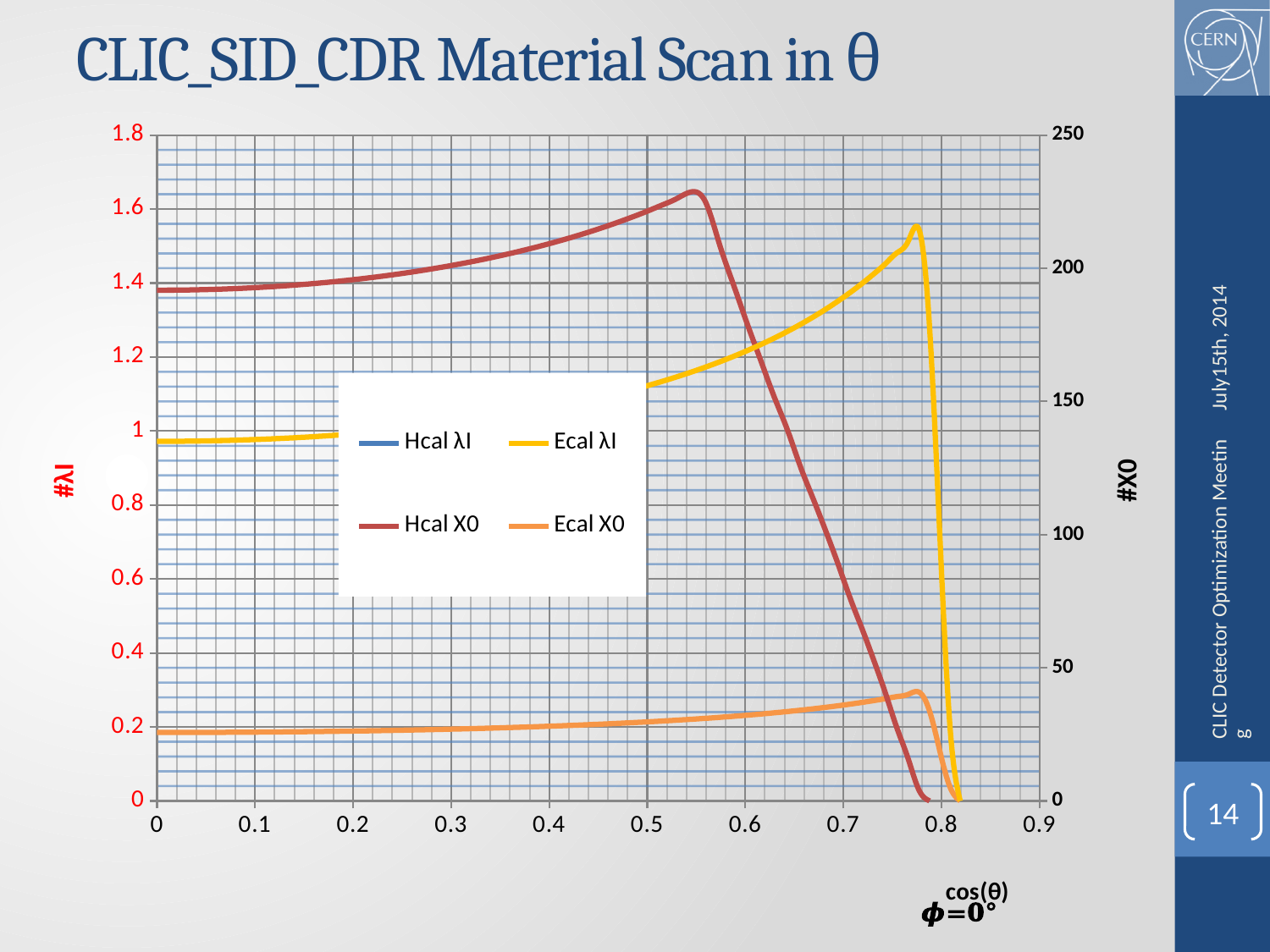
What is the title of the chart? CLIC_SID_CDR Material Scan in θ At cos(θ)=0, which line is higher on the chart, Hcal X0 or Ecal X0? Hcal X0 Does the Hcal X0 line rise or fall between cos(θ)=0.6 and cos(θ)=0.8? fall Does the Ecal X0 line rise or fall between cos(θ)=0 and cos(θ)=0.7? rise On the right-hand #X0 axis, is the value for Hcal X0 at cos(θ)=0 greater or less than 150? greater On the left-hand #λI axis, is the value for Ecal λI at cos(θ)=0 greater or less than 0.8? greater How many series does the legend list? 4 On the right-hand #X0 axis, is the value for Ecal X0 at cos(θ)=0 greater or less than 50? less Which series reaches its peak at a larger cos(θ) value, Hcal X0 or Ecal λI? Ecal λI What kind of chart is shown on the slide? line chart What are the four series named in the legend? Hcal λI, Ecal λI, Hcal X0, Ecal X0 How many labelled tick marks are there on the x axis? 10